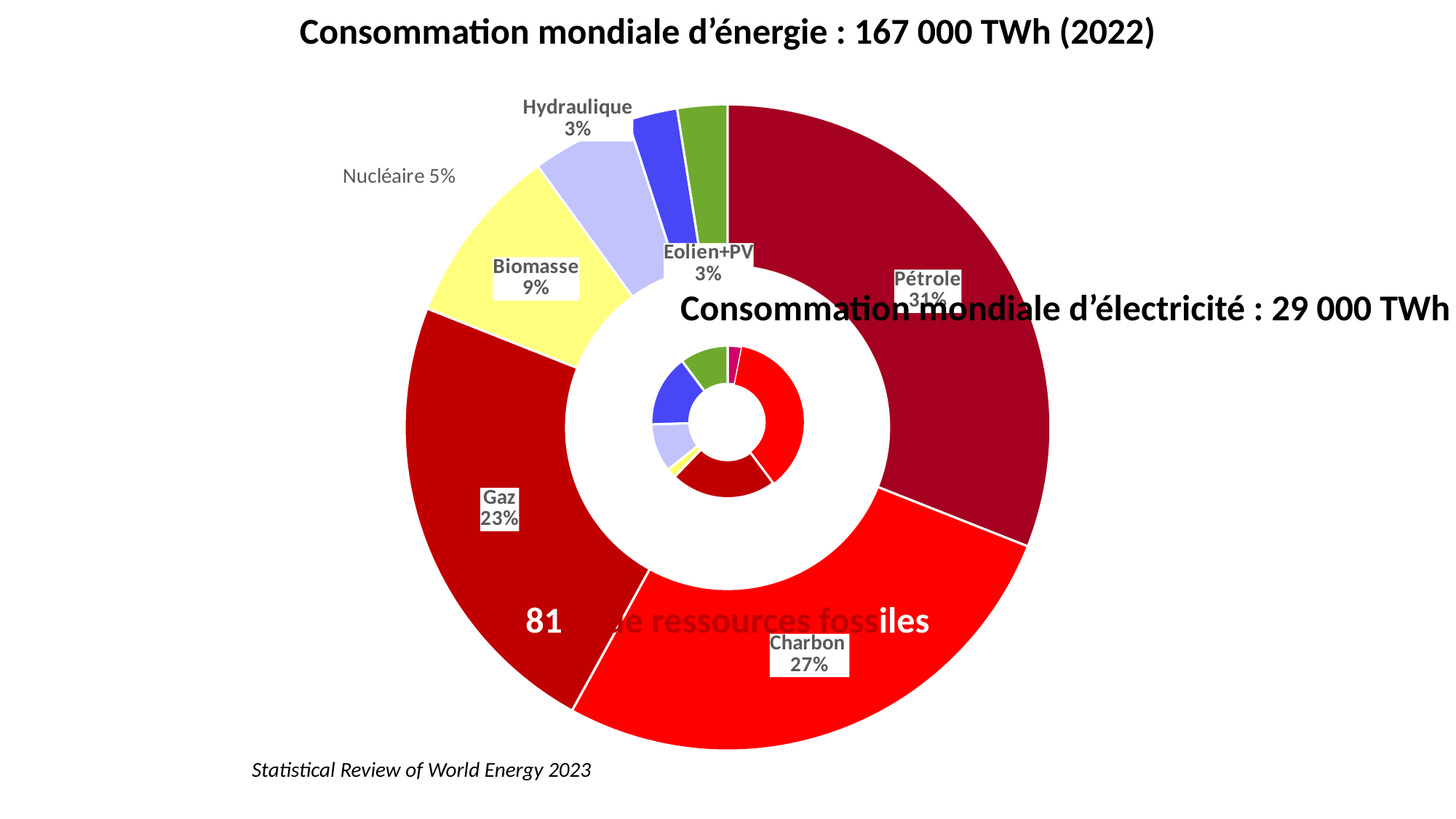
In the 'Consommation mondiale d'énergie' chart, what is the difference in share between Biomasse and Nucléaire? 4% In the 'Consommation mondiale d'énergie' chart, what share does Gaz have? 23% In the 'Consommation mondiale d'énergie' chart, what share does Nucléaire have? 5% In the 'Consommation mondiale d'énergie' chart, which category has the largest share? Pétrole How many labelled categories are shown in the 'Consommation mondiale d'énergie' chart? 7 In the 'Consommation mondiale d'énergie' chart, what share does Charbon have? 27% In the 'Consommation mondiale d'énergie' chart, what is the difference in share between Charbon and Gaz? 4% What total energy consumption value is given in the title of the outer chart? 167 000 TWh What kind of chart is the 'Consommation mondiale d'énergie' chart? Doughnut chart In the 'Consommation mondiale d'énergie' chart, what share does Hydraulique have? 3% In the 'Consommation mondiale d'énergie' chart, which has the larger share, Gaz or Charbon? Charbon In the 'Consommation mondiale d'énergie' chart, what share does Biomasse have? 9%